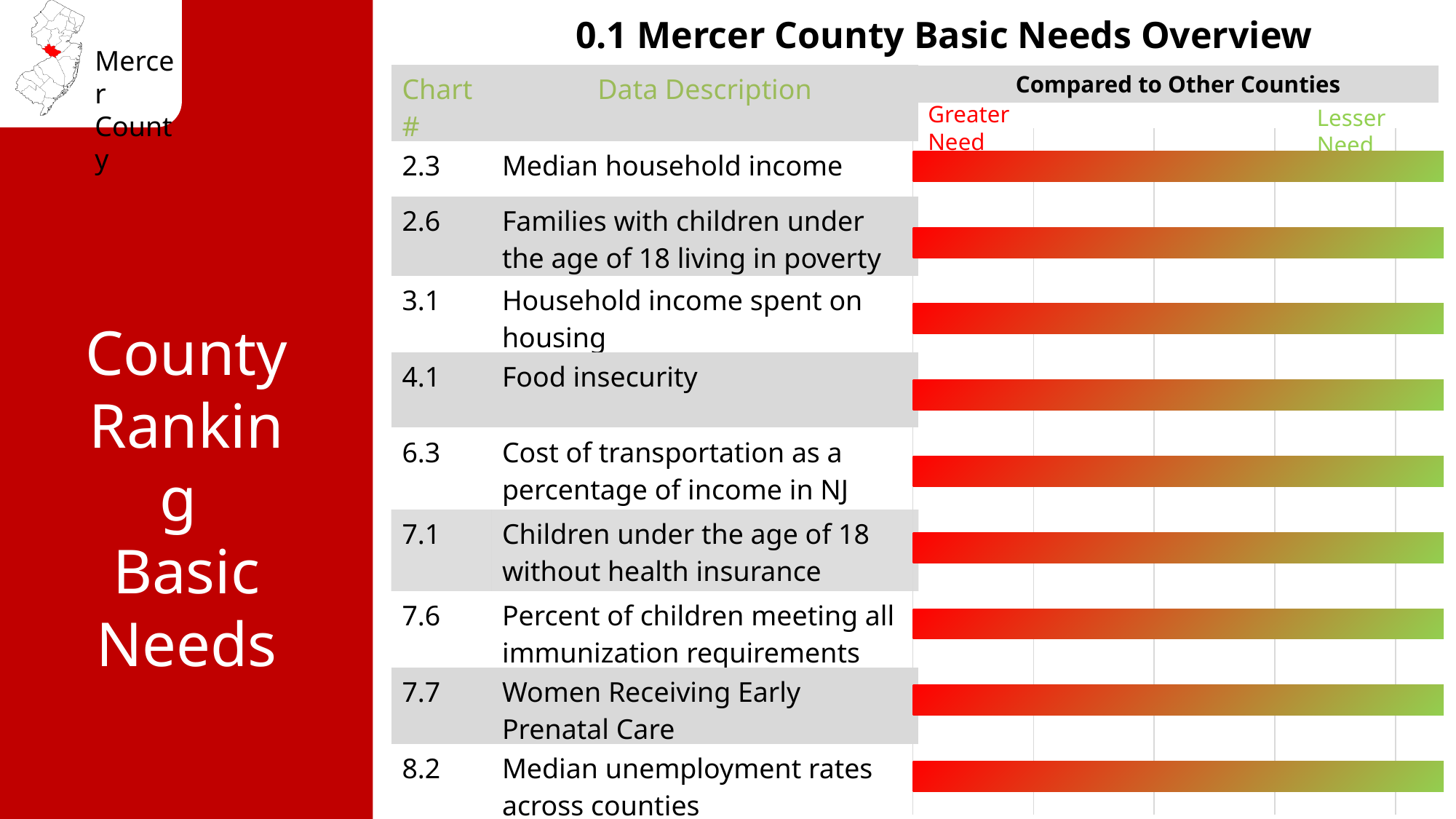
Which data description is listed with chart number 8.2? Median unemployment rates across counties What label appears at the left end of the bar scale, and what label appears at the right end? Greater Need; Lesser Need How many data descriptions (rows) are listed in the chart? 9 What chart number is listed for Food insecurity? 4.1 Which data description is listed with chart number 7.1? Children under the age of 18 without health insurance Which data description is listed with chart number 3.1? Household income spent on housing What chart number is listed for Median household income? 2.3 What is the title of the chart? 0.1 Mercer County Basic Needs Overview What kind of chart is shown on the slide? bar chart What chart number is listed for Women Receiving Early Prenatal Care? 7.7